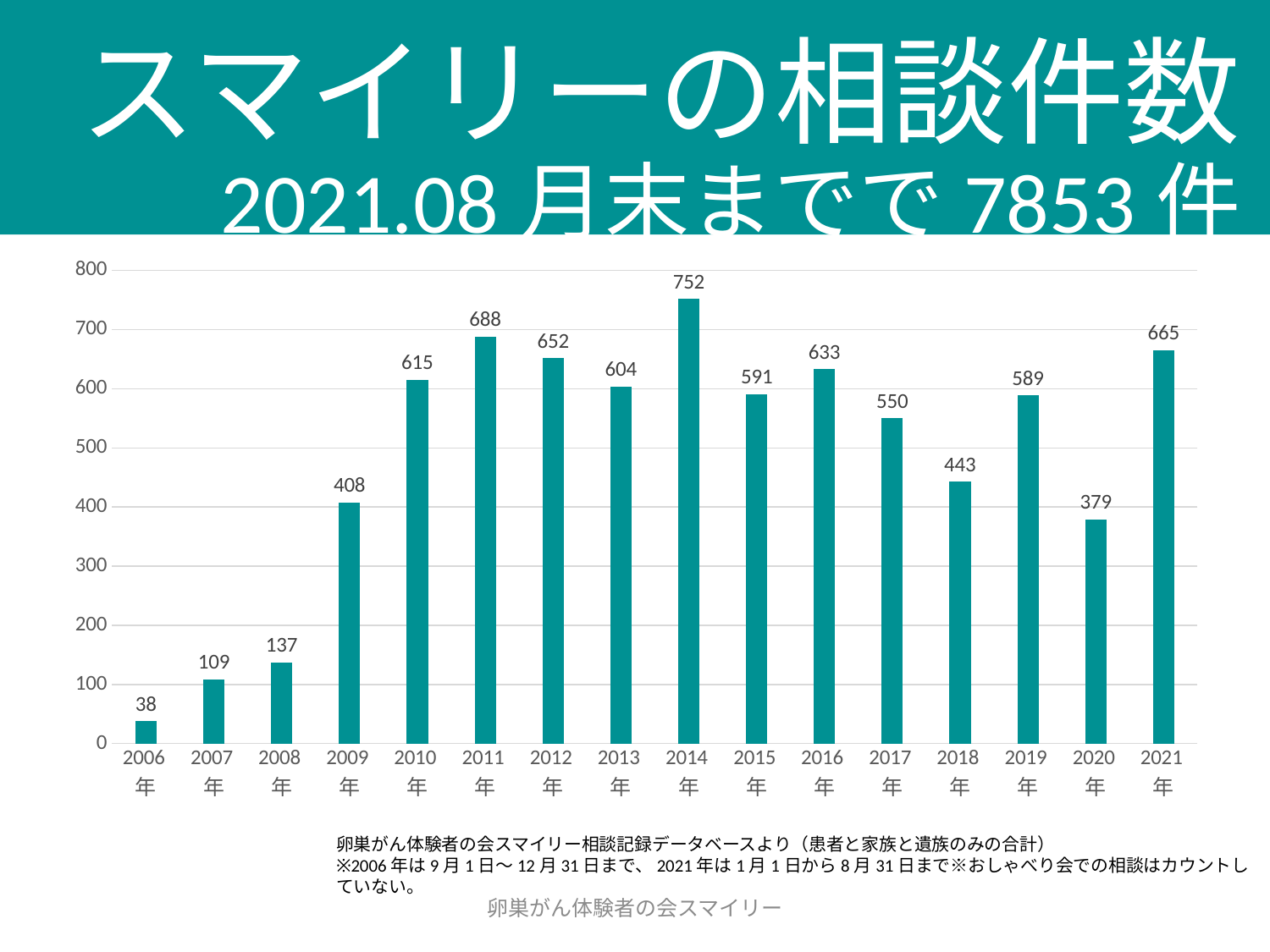
Which is larger, the value for 2011年 or the value for 2012年? 2011年 What is the difference between the values for 2021年 and 2020年? 286 What is the value for 2006年? 38 What is the difference between the values for 2014年 and 2013年? 148 What is the value for 2020年? 379 Do the values rise or fall from 2006年 to 2009年? rise What is the value for 2014年? 752 Which year has the highest value? 2014年 What kind of chart is shown on the slide? bar chart Is the value for 2018年 greater or less than 400? greater How many years are shown on the x axis? 16 Which year has the lowest value? 2006年